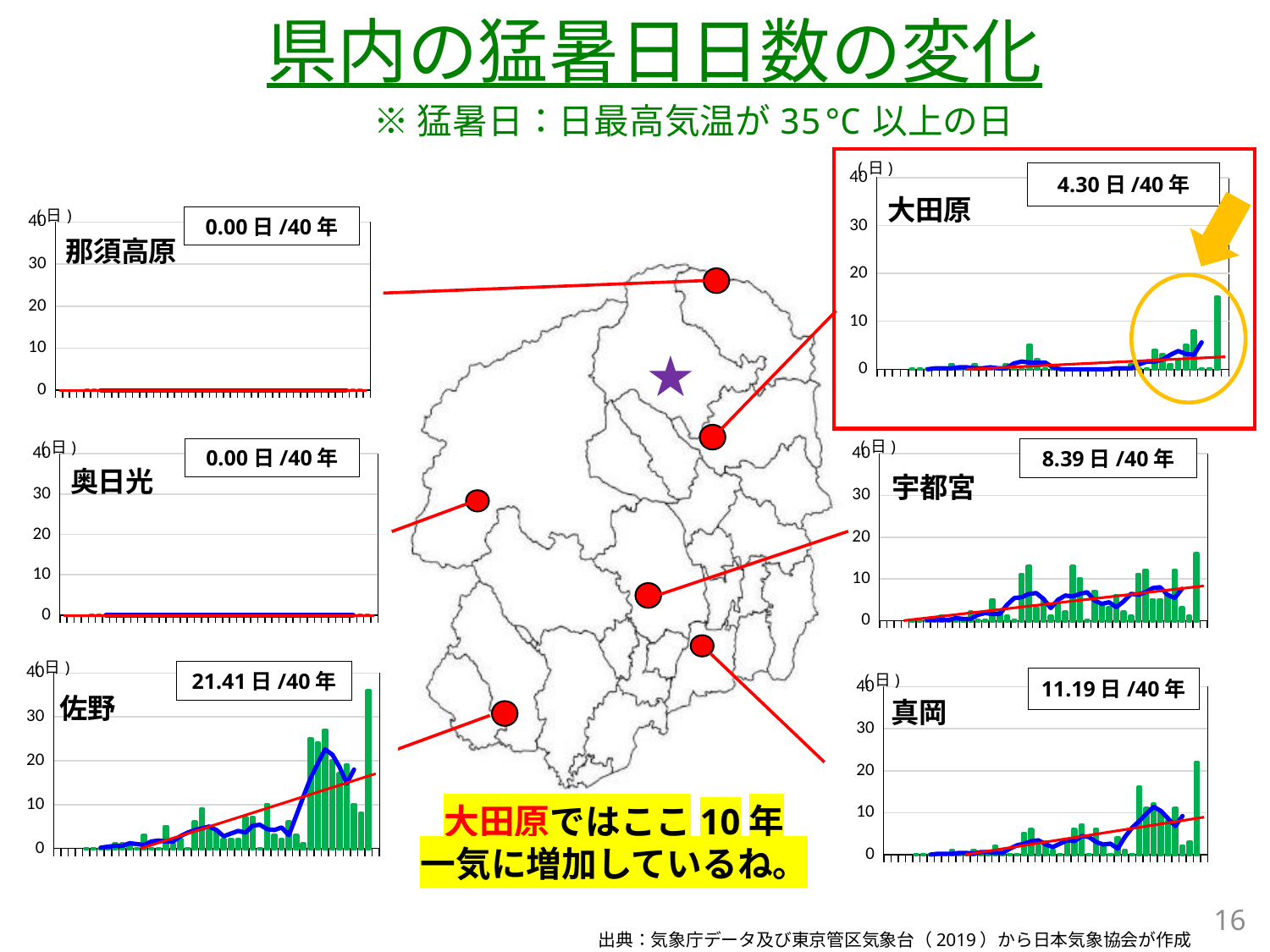
Which has the larger printed rate of change, 宇都宮 or 真岡? 真岡 On the 宇都宮 chart, what rate of change is printed in the box? 8.39 日/40 年 On the 大田原 chart, is the tallest bar greater or less than 10? greater On the 大田原 chart, what rate of change is printed in the box? 4.30 日/40 年 On the 佐野 chart, is the tallest bar greater or less than 30? greater On the 佐野 chart, what rate of change is printed in the box? 21.41 日/40 年 On the 那須高原 chart, what rate of change is printed in the box? 0.00 日/40 年 Which station's chart is outlined with a red box on the slide? 大田原 On the 真岡 chart, what rate of change is printed in the box? 11.19 日/40 年 Which station's chart shows the largest printed rate of change (日/40 年)? 佐野 How many station charts are shown on the slide? 6 What is the difference between the printed rates of change for 佐野 and 真岡? 10.22 日/40 年